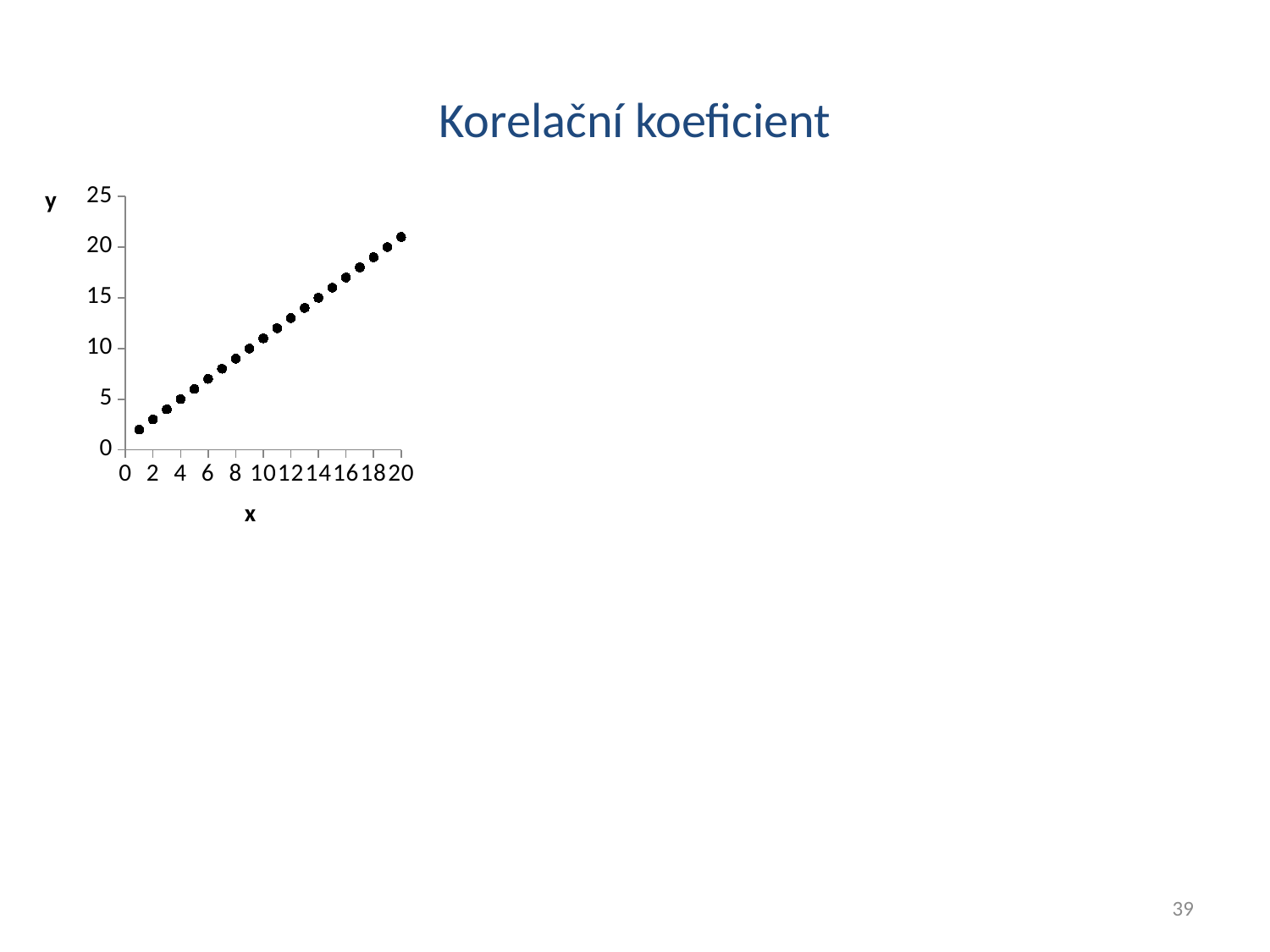
Is the y value at x = 6 greater or less than 10? less What is the highest value shown on the vertical axis? 25 Is the y value at x = 18 greater or less than 15? greater How many data points are plotted in the chart? 20 What kind of chart is shown on the slide? scatter plot Is the y value at x = 2 greater or less than 5? less At which x value is the y value lowest? 1 Do the y values rise or fall as x increases? rise What is the label of the vertical axis? y At which x value is the y value highest? 20 Which has the larger y value, the point at x = 8 or the point at x = 14? x = 14